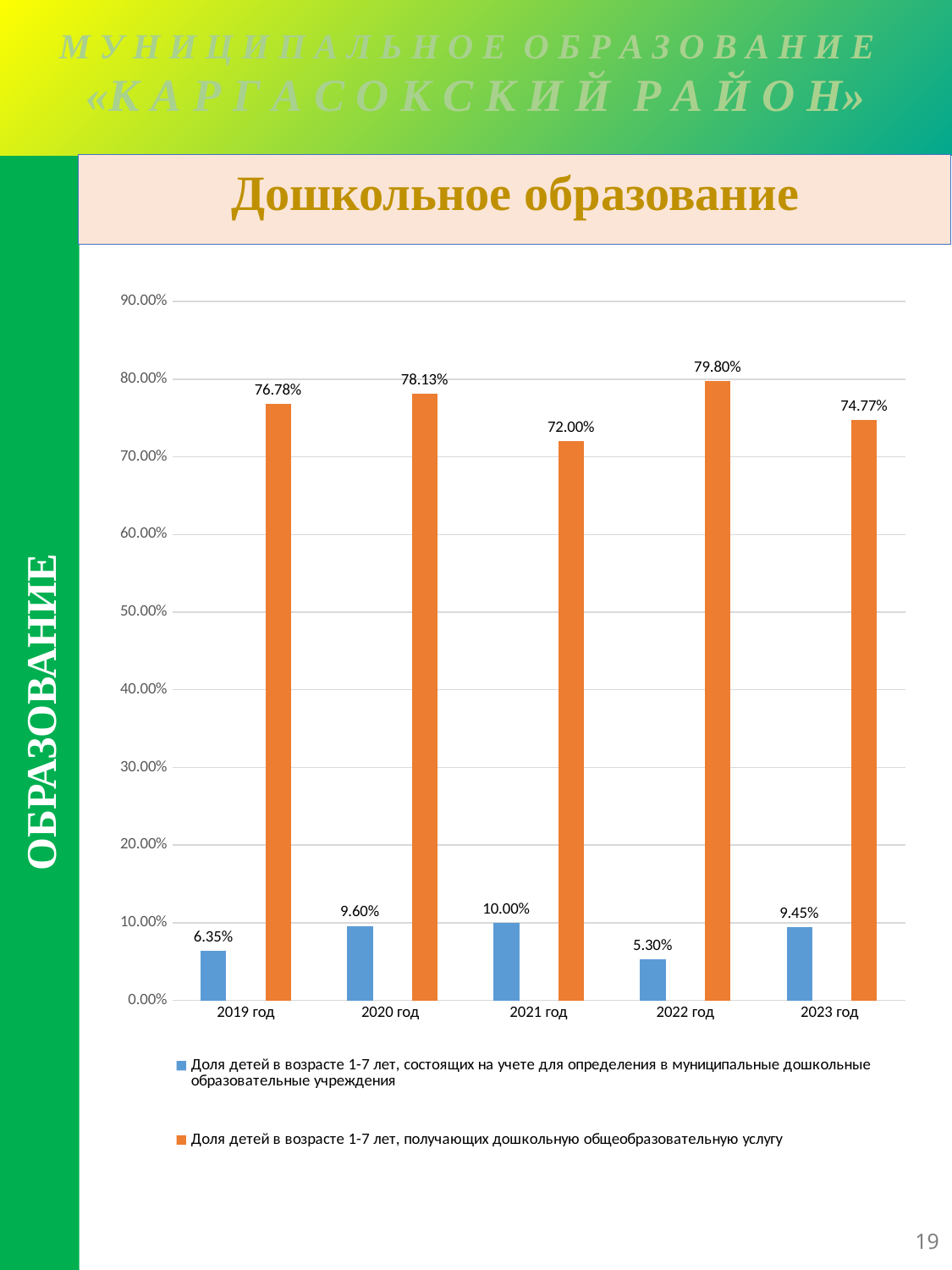
How many years are shown on the x axis of the chart? 5 Which is larger: the orange series value for 2020 год or for 2023 год? 2020 год How many series does the chart legend list? 2 What type of chart is shown on the slide? bar chart What is the difference between the blue series values for 2021 год and 2022 год? 4.70% What is the share of children aged 1-7 registered for placement in municipal preschool institutions (blue series) in 2019 год? 6.35% In which year is the share of children receiving preschool general education services (orange series) the highest? 2022 год What is the share of children aged 1-7 receiving preschool general education services (orange series) in 2022 год? 79.80% What is the value of the orange series (children receiving preschool services) for 2021 год? 72.00% What is the difference between the orange series values for 2022 год and 2021 год? 7.80% Is the blue series value for 2021 год greater or less than 20.00%? less In which year is the share of children registered for placement in preschool institutions (blue series) the lowest? 2022 год